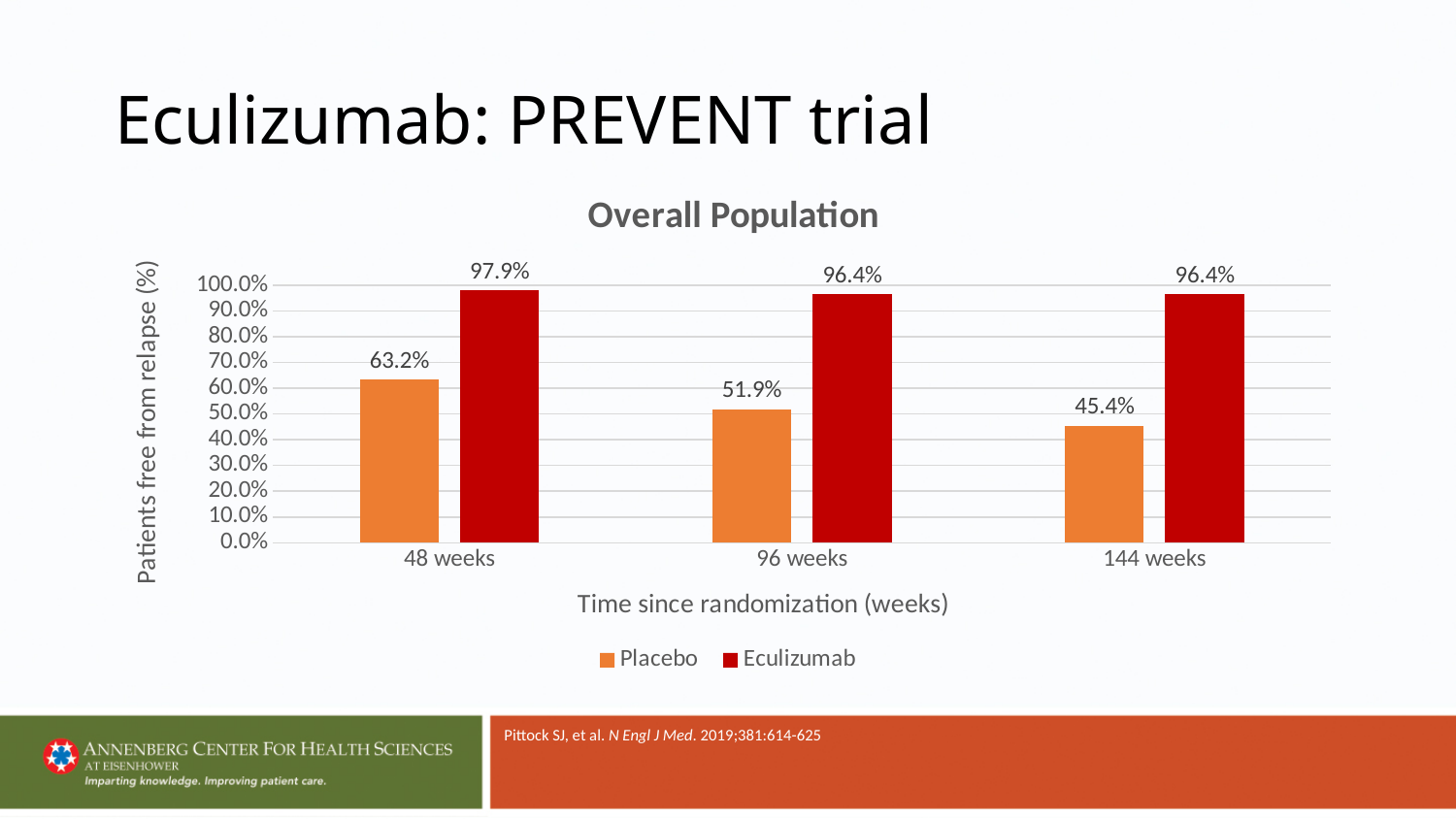
Which is larger at 144 weeks, the Placebo value or the Eculizumab value? Eculizumab What is the value for Placebo at 48 weeks? 63.2% What is the value for Placebo at 144 weeks? 45.4% At which time point is the Placebo value lowest? 144 weeks What kind of chart is shown on the slide? Bar chart What is the difference between the Eculizumab and Placebo values at 48 weeks? 34.7% How many time points are shown on the x axis? 3 What is the value for Eculizumab at 96 weeks? 96.4% What is the difference between the Placebo values at 48 weeks and 96 weeks? 11.3% At which time point is the Eculizumab value highest? 48 weeks Do the Placebo values rise or fall from 48 weeks to 144 weeks? Fall How many series does the legend list? 2